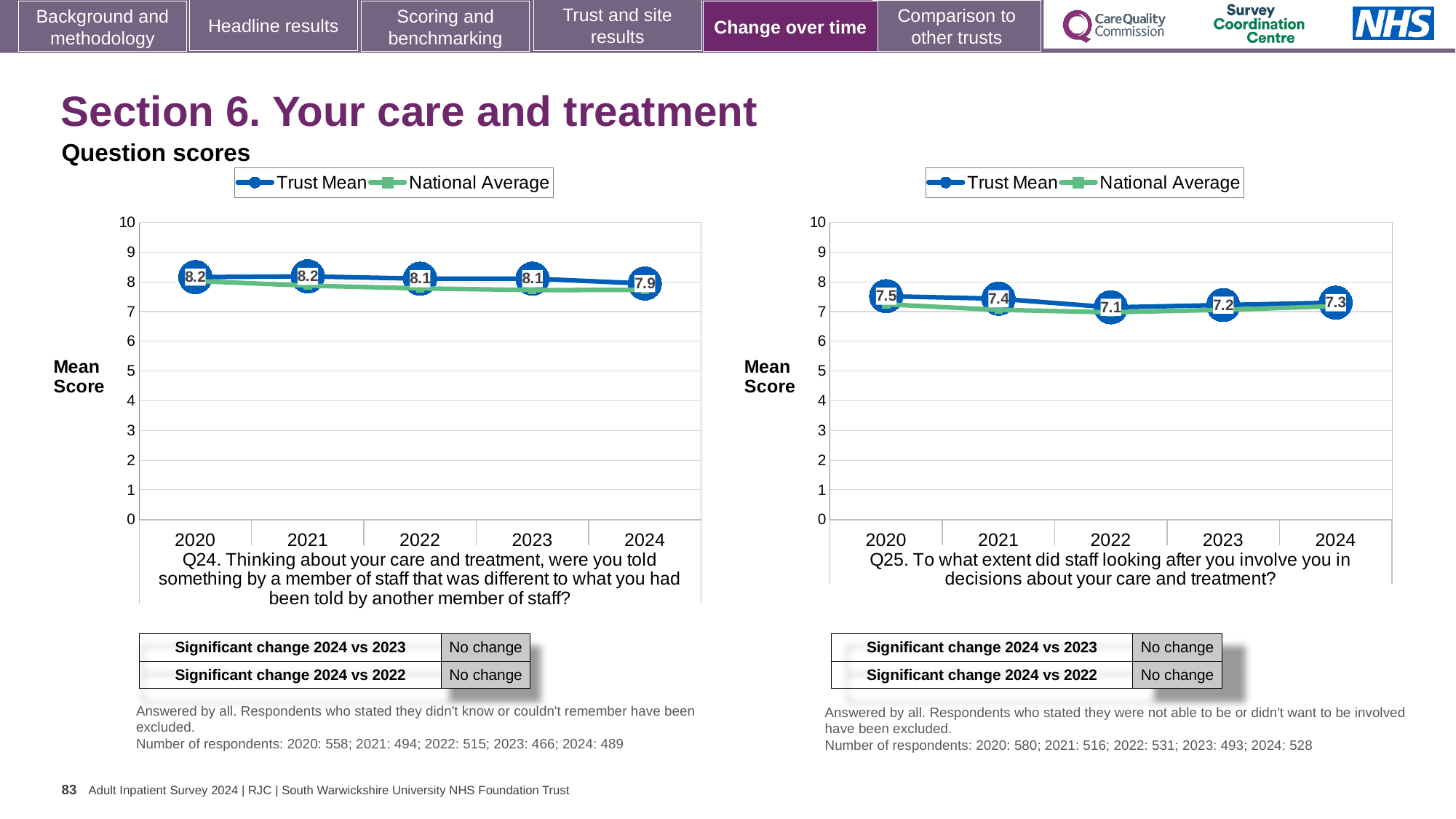
How many years are plotted on the Q24 chart (left)? 5 On the Q24 chart (left), what is the Trust Mean score for 2024? 7.9 On the Q24 chart (left), what is the difference between the Trust Mean score in 2020 and in 2024? 0.3 On the Q25 chart (right), which year has the lowest Trust Mean score? 2022 On the Q25 chart (right), is the Trust Mean score for 2020 larger or smaller than the score for 2022? larger On the Q25 chart (right), what is the Trust Mean score for 2024? 7.3 On the Q24 chart (left), what is the Trust Mean score for 2020? 8.2 On the Q25 chart (right), what is the Trust Mean score for 2022? 7.1 How many series does the legend of the Q25 chart (right) list? 2 On the Q25 chart (right), which year has the highest Trust Mean score? 2020 What type of chart is used for Q24 (left)? Line chart On the Q24 chart (left), is the National Average value for 2024 greater or less than 5? greater